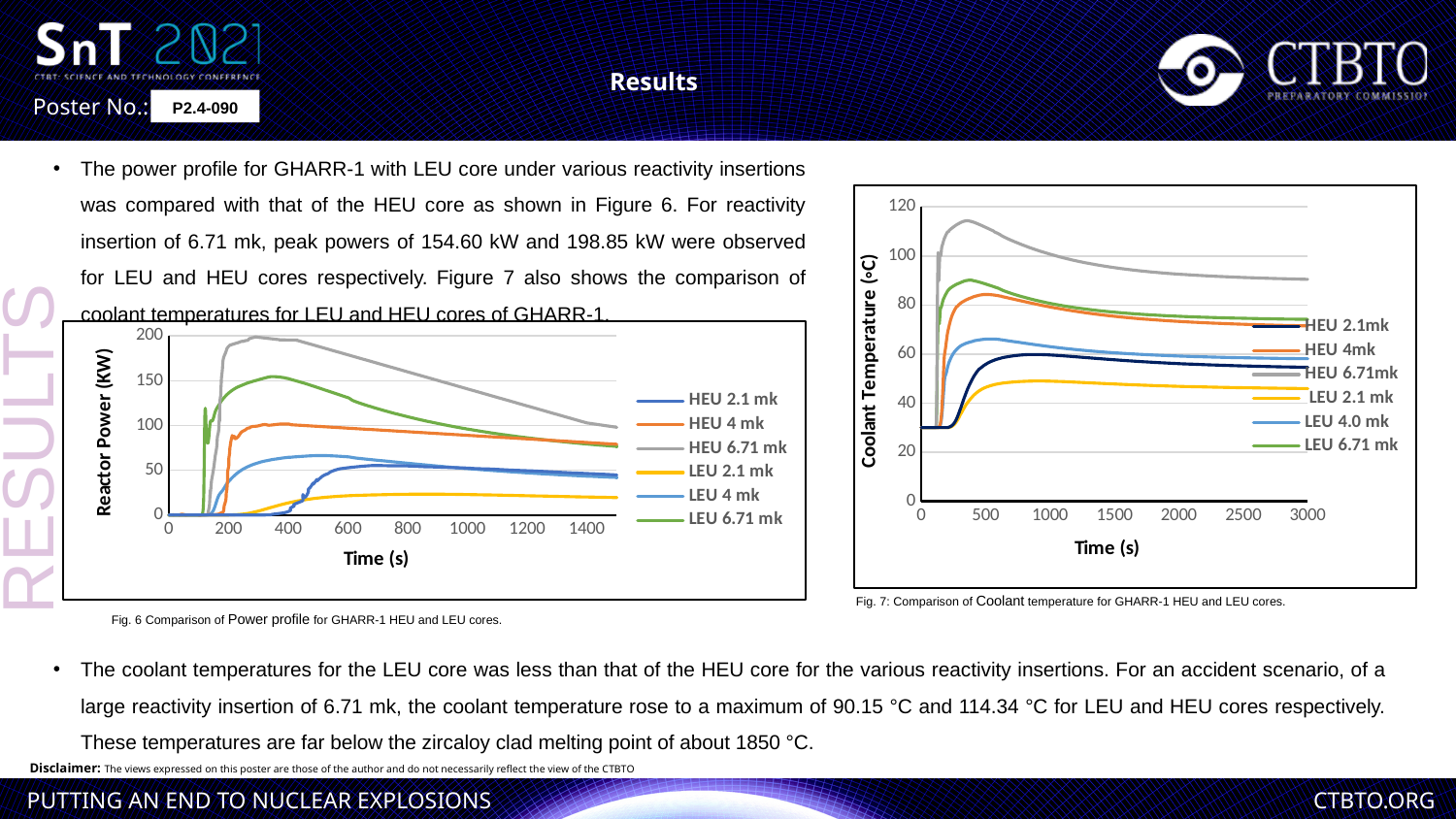
How many series does the legend of the right chart (Coolant Temperature) list? 6 In the left chart (Reactor Power), which series reaches the highest peak power? HEU 6.71 mk In the left chart (Reactor Power), is the peak value for LEU 2.1 mk greater or less than 50? less In the right chart (Coolant Temperature), after its peak, does the HEU 6.71mk temperature rise or fall as time approaches 3000 s? fall In the right chart (Coolant Temperature), which series has the higher peak: LEU 6.71 mk or HEU 6.71mk? HEU 6.71mk In the left chart (Reactor Power), which series has the lowest peak power? LEU 2.1 mk What kind of chart is the left chart (Reactor Power vs Time)? line chart In the left chart (Reactor Power), is the peak value for HEU 6.71 mk greater or less than 150? greater In the right chart (Coolant Temperature), which series reaches the highest peak temperature? HEU 6.71mk In the right chart (Coolant Temperature), which series has the lowest peak temperature? LEU 2.1 mk In the right chart (Coolant Temperature), is the peak value for HEU 6.71mk greater or less than 100? greater How many series does the legend of the left chart (Reactor Power) list? 6